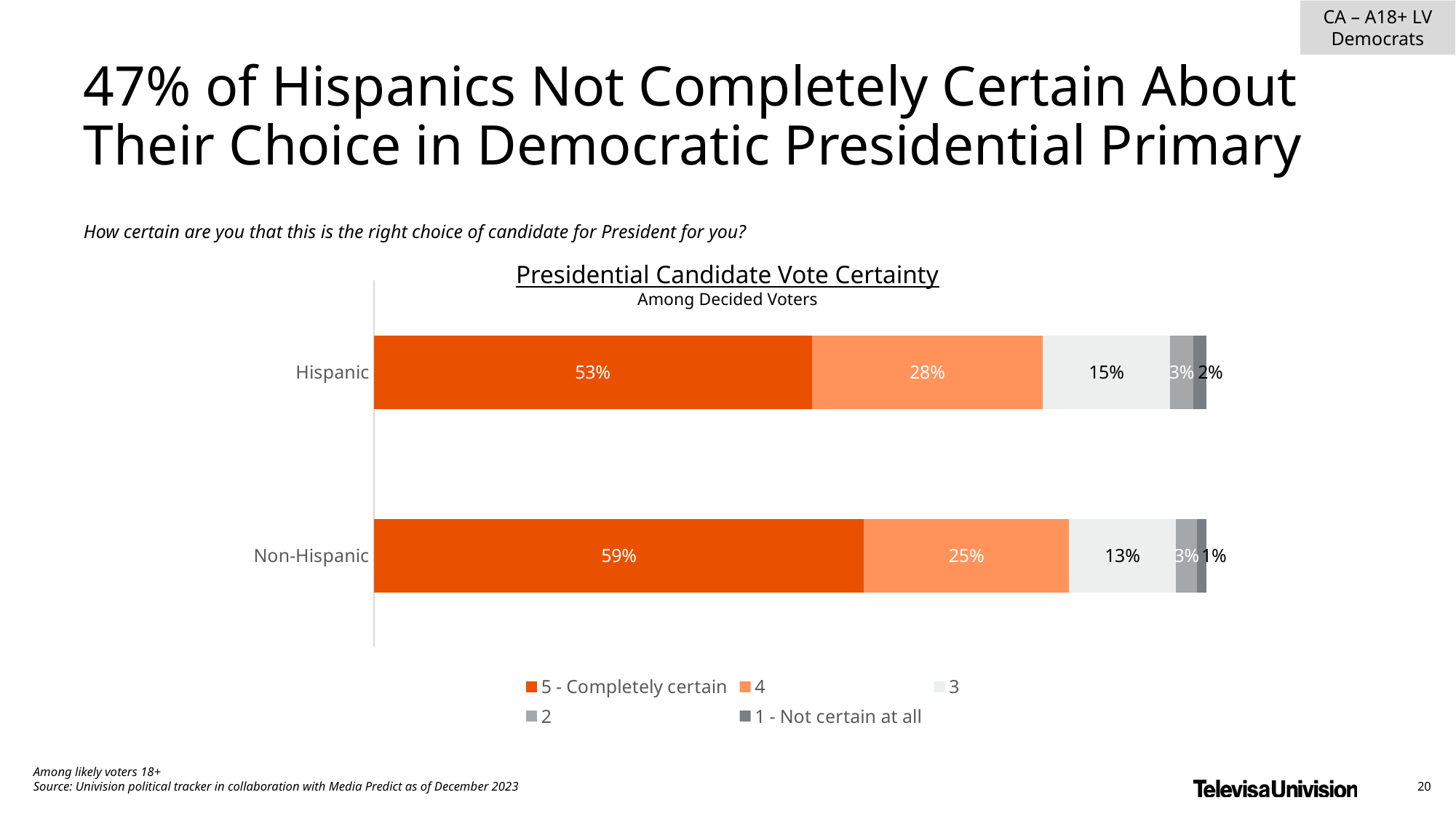
What is the difference between the Non-Hispanic and Hispanic shares of completely certain voters? 6 percentage points What percentage of Non-Hispanic voters are '1 - Not certain at all'? 1% What is the difference between the Hispanic and Non-Hispanic shares for the '4' rating? 3 percentage points How many groups (categories) are shown in the chart? 2 What type of chart is shown on the slide? Stacked bar chart What percentage of Non-Hispanic decided voters are completely certain (5) about their candidate choice? 59% What is the value for the '4' rating among Hispanic voters? 28% What percentage of Hispanic decided voters are completely certain (5) about their candidate choice? 53% What is the value for the '3' rating among Non-Hispanic voters? 13% How many series does the legend list? 5 Which group has the higher share of voters who are completely certain, Hispanic or Non-Hispanic? Non-Hispanic What percentage of Hispanic voters are '1 - Not certain at all'? 2%